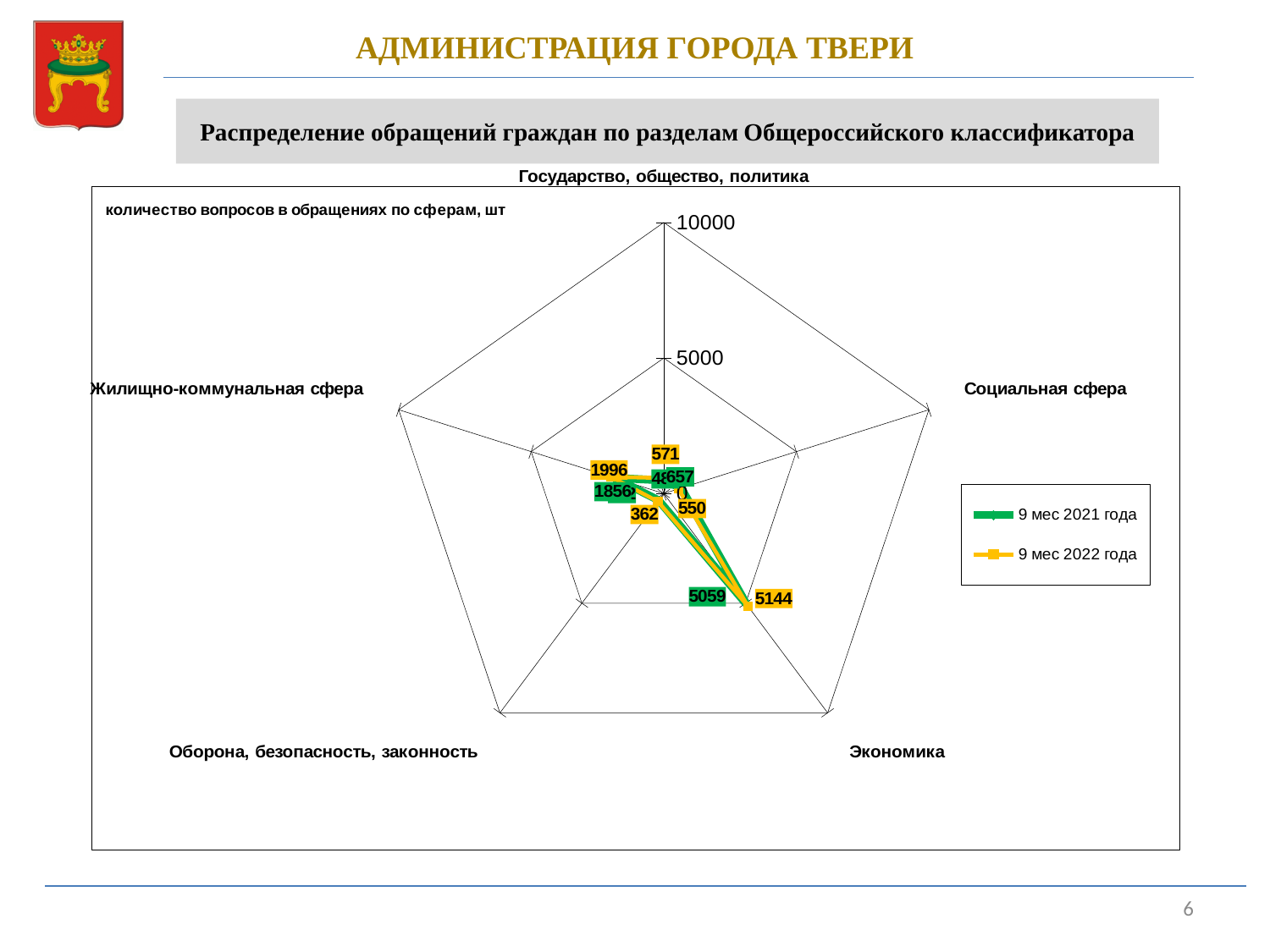
What is the value for Жилищно-коммунальная сфера in the series 9 мес 2021 года? 1856 How many series does the legend list? 2 How many categories (axes) does the radar chart have? 5 What is the value for Экономика in the series 9 мес 2022 года? 5144 What kind of chart is shown on the slide? radar chart Which is larger for Жилищно-коммунальная сфера: the 9 мес 2021 года value or the 9 мес 2022 года value? 9 мес 2022 года What is the value for Жилищно-коммунальная сфера in the series 9 мес 2022 года? 1996 What is the difference between the 9 мес 2022 года and 9 мес 2021 года values for Экономика? 85 What is the value for Государство, общество, политика in the series 9 мес 2022 года? 571 Which category has the highest value in the series 9 мес 2022 года? Экономика What is the value for Экономика in the series 9 мес 2021 года? 5059 Is the value for Экономика in 9 мес 2022 года greater or less than 5000? greater